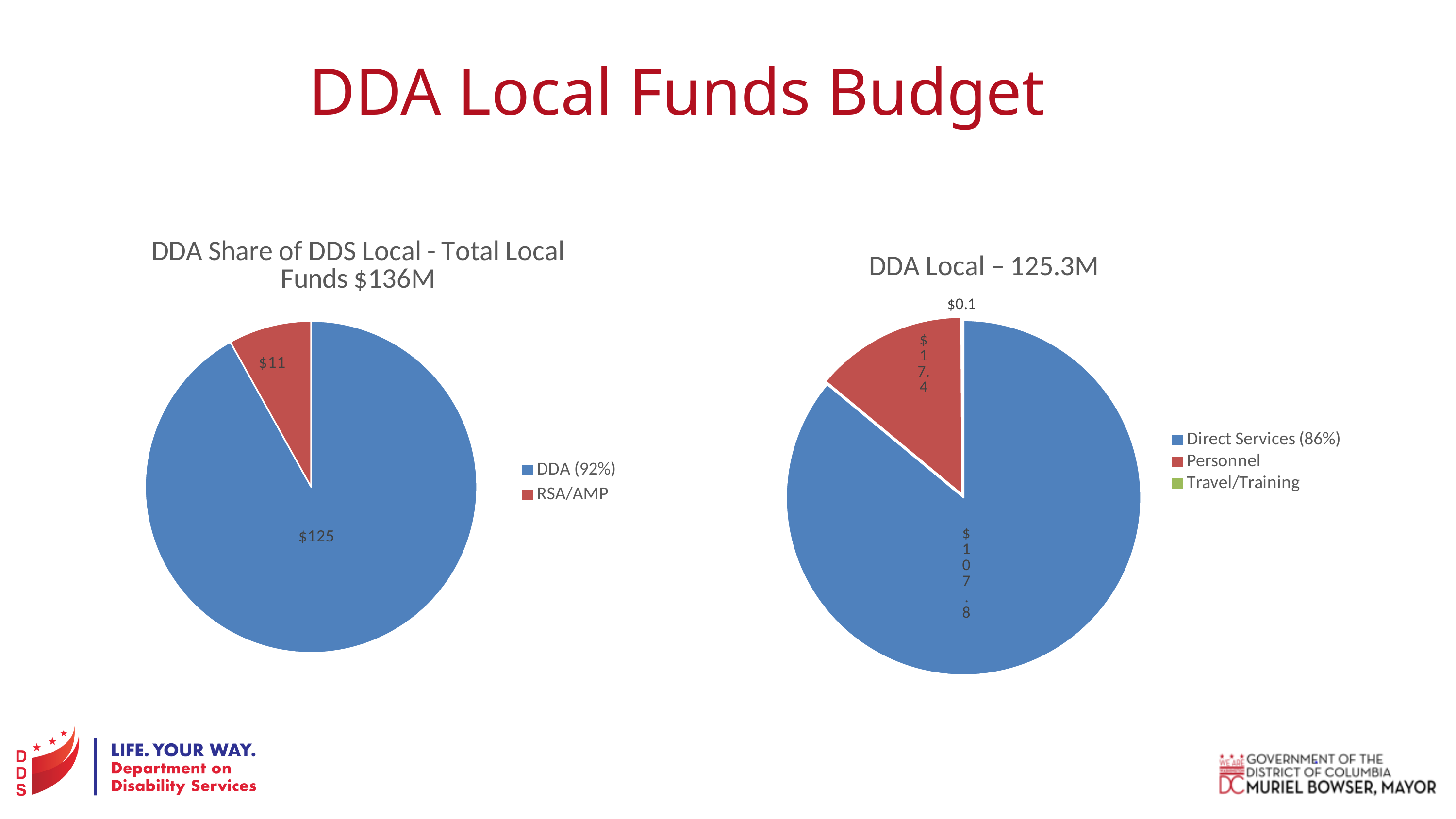
In the left chart, DDA Share of DDS Local, what is the value for RSA/AMP? $11 In the right chart, DDA Local – 125.3M, what is the difference between Direct Services and Personnel? $90.4 How many categories does the legend of the right chart, DDA Local – 125.3M, list? 3 In the left chart, DDA Share of DDS Local, what percentage share does the legend give for DDA? 92% In the right chart, DDA Local – 125.3M, what is the value for Travel/Training? $0.1 In the right chart, DDA Local – 125.3M, which category has the largest slice? Direct Services In the right chart, DDA Local – 125.3M, what is the value for Direct Services? $107.8 In the left chart, DDA Share of DDS Local, what is the value for DDA? $125 What type of chart is the left chart, DDA Share of DDS Local? Pie chart In the right chart, DDA Local – 125.3M, what is the value for Personnel? $17.4 In the left chart, DDA Share of DDS Local, what is the difference between the DDA value and the RSA/AMP value? $114 In the right chart, DDA Local – 125.3M, which category has the smallest slice? Travel/Training